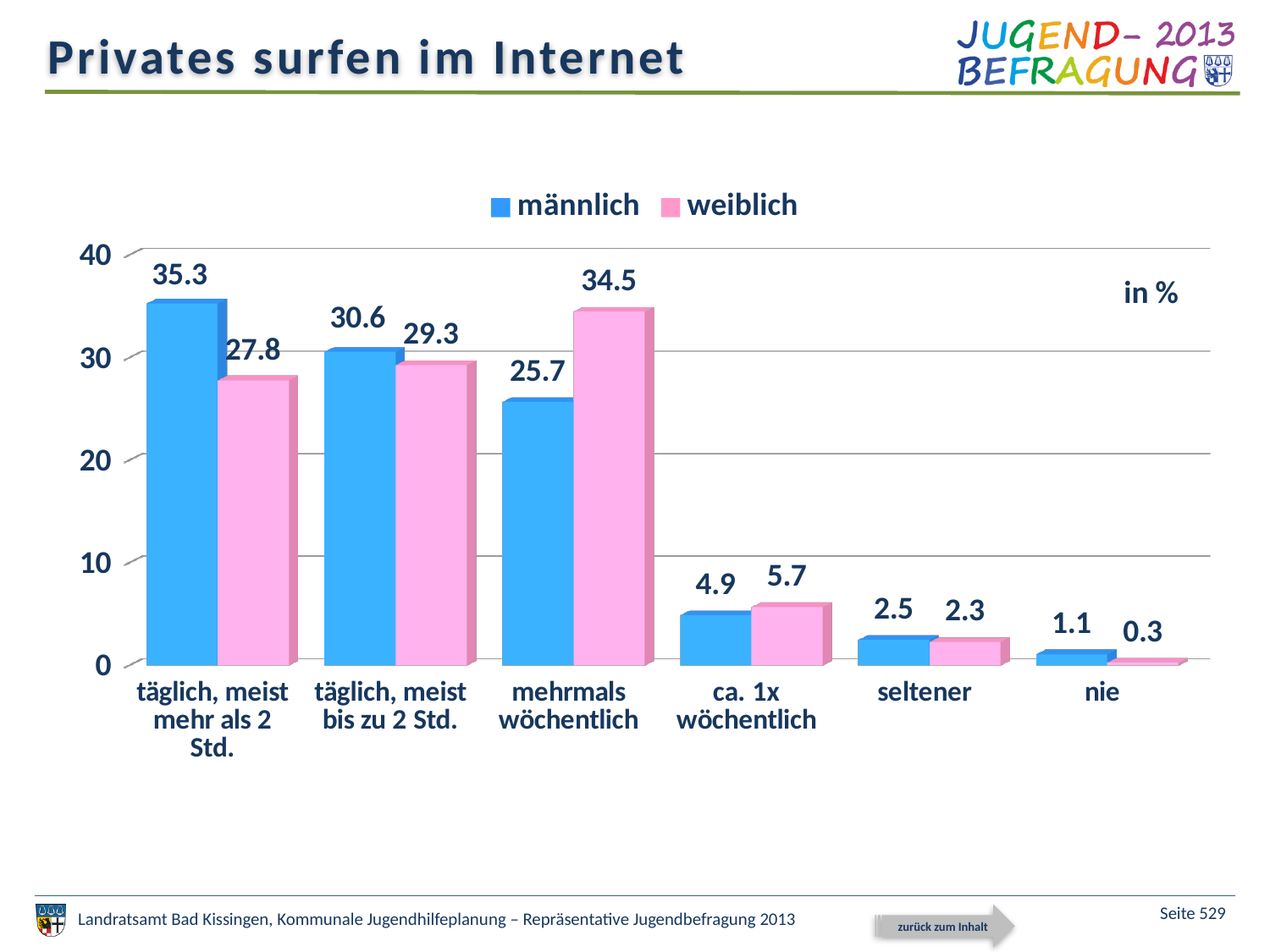
How many categories are shown on the x axis? 6 What is the difference between the männlich and weiblich values in the category 'täglich, meist mehr als 2 Std.'? 7.5 What is the value for männlich in the category 'täglich, meist mehr als 2 Std.'? 35.3 In the category 'mehrmals wöchentlich', which series has the larger value, männlich or weiblich? weiblich Which category has the lowest value for weiblich? nie What is the value for weiblich in the category 'nie'? 0.3 What unit is indicated for the values in the chart? in % How many series does the legend list? 2 Which category has the highest value for männlich? täglich, meist mehr als 2 Std. What kind of chart is shown on the slide? bar chart Is the value for männlich in the category 'täglich, meist bis zu 2 Std.' greater or less than 30? greater What is the value for weiblich in the category 'mehrmals wöchentlich'? 34.5